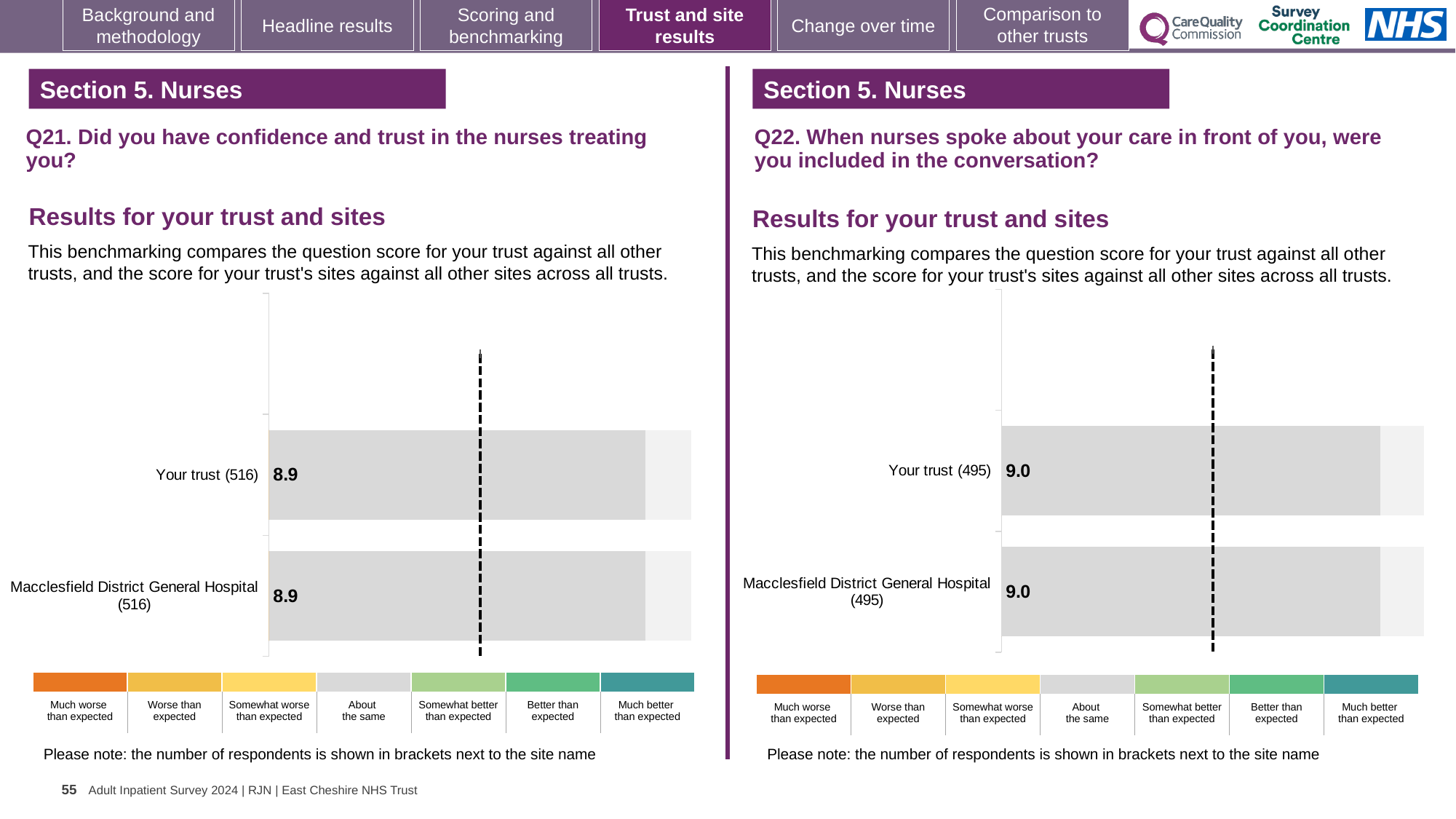
On the Q21 chart (left), what is the score for Macclesfield District General Hospital (516)? 8.9 On the Q22 chart (right), what is the score for Your trust (495)? 9.0 What kind of chart is used on the Q22 chart (right)? Bar chart On the Q21 chart (left), what is the score for Your trust (516)? 8.9 How many bars are plotted on the Q21 chart (left)? 2 How many bars are plotted on the Q22 chart (right)? 2 On the Q21 chart (left), how many respondents are shown in brackets for Your trust? 516 On the Q21 chart (left), what is the difference between the score for Your trust and the score for Macclesfield District General Hospital? 0.0 Is the score for Your trust on the Q22 chart (right) greater or less than the score for Your trust on the Q21 chart (left)? greater On the Q22 chart (right), what is the difference between the score for Your trust and the score for Macclesfield District General Hospital? 0.0 On the Q22 chart (right), how many respondents are shown in brackets for Macclesfield District General Hospital? 495 On the Q22 chart (right), what is the score for Macclesfield District General Hospital (495)? 9.0